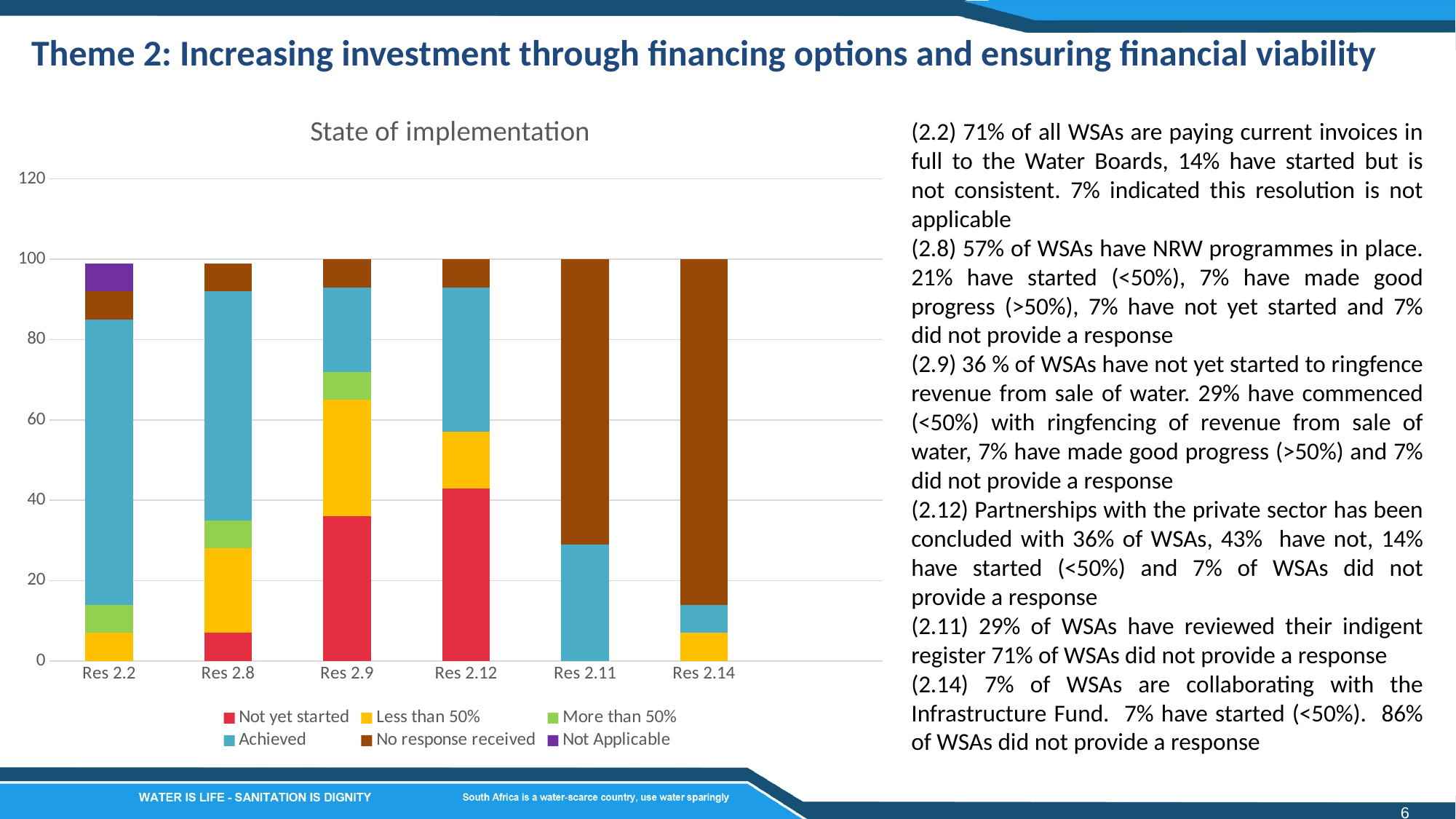
Which category is the only one with a 'Not Applicable' segment? Res 2.2 How many categories are shown on the x axis of the chart? 6 What kind of chart is shown on the slide? Stacked bar chart Which category has the largest 'No response received' segment? Res 2.14 Which category has the smallest 'Achieved' segment? Res 2.14 Is the 'Achieved' segment for Res 2.2 greater or less than 60? greater Is the 'Not yet started' segment for Res 2.9 greater or less than 40? less What is the title of the chart? State of implementation Which category has the largest 'Achieved' segment? Res 2.2 How many series does the chart legend list? 6 Is the 'No response received' segment for Res 2.11 greater or less than 60? greater Which is larger: the 'Not yet started' segment for Res 2.12 or for Res 2.9? Res 2.12